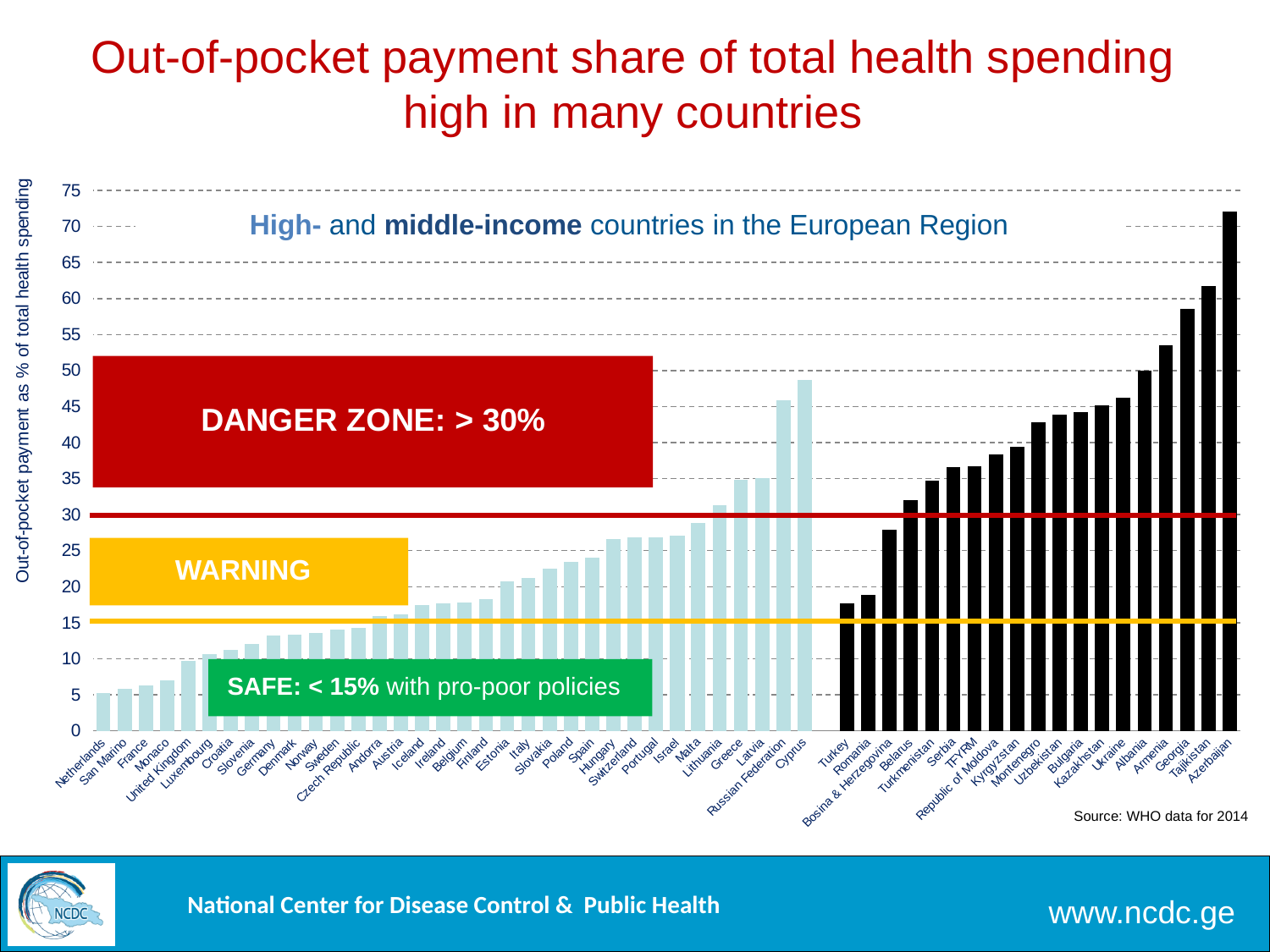
Which country has the highest out-of-pocket payment share? Azerbaijan According to the chart, what threshold defines the danger zone? > 30% Is the value for Netherlands greater or less than 10? less Which has a larger out-of-pocket payment share, Cyprus or Greece? Cyprus Which country has the lowest out-of-pocket payment share? Netherlands What kind of chart is shown on the slide? bar chart Do the values generally rise or fall from left to right along the x axis? rise Is the value for Bosina & Herzegovina greater or less than 30? less Is the value for Azerbaijan greater or less than 65? greater